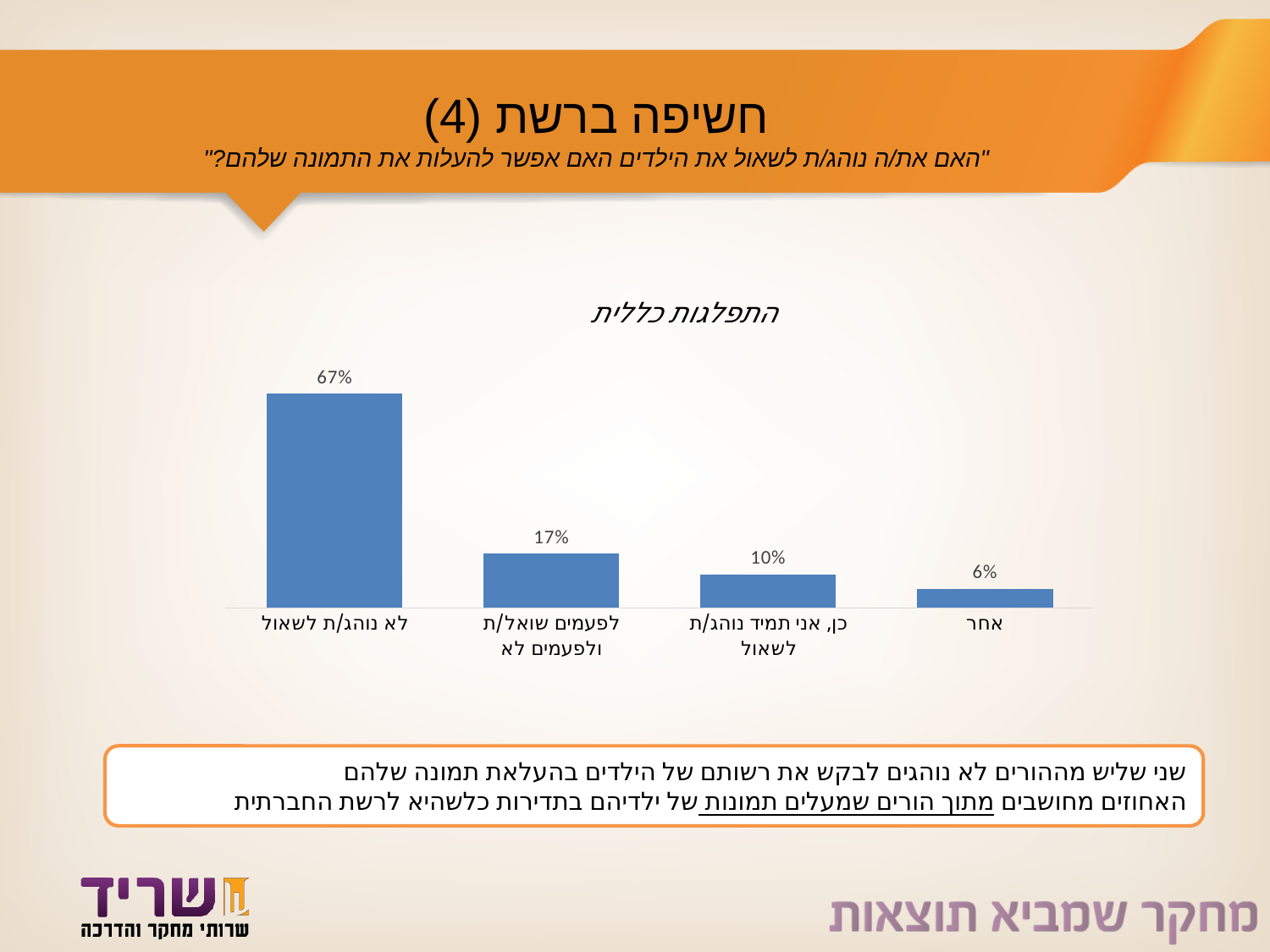
What kind of chart is shown on the slide? Bar chart Which category has the highest value? לא נוהג/ת לשאול What is the difference between the values for "כן, אני תמיד נוהג/ת לשאול" and "אחר"? 4% What is the difference between the values for "לא נוהג/ת לשאול" and "לפעמים שואל/ת ולפעמים לא"? 50% What is the value for "אחר"? 6% How many categories are shown in the chart? 4 What is the value for "לפעמים שואל/ת ולפעמים לא"? 17% Which is larger: the value for "לפעמים שואל/ת ולפעמים לא" or the value for "כן, אני תמיד נוהג/ת לשאול"? לפעמים שואל/ת ולפעמים לא Which category has the lowest value? אחר What is the value for "כן, אני תמיד נוהג/ת לשאול"? 10% What is the value for "לא נוהג/ת לשאול"? 67% What is the title of the chart? התפלגות כללית